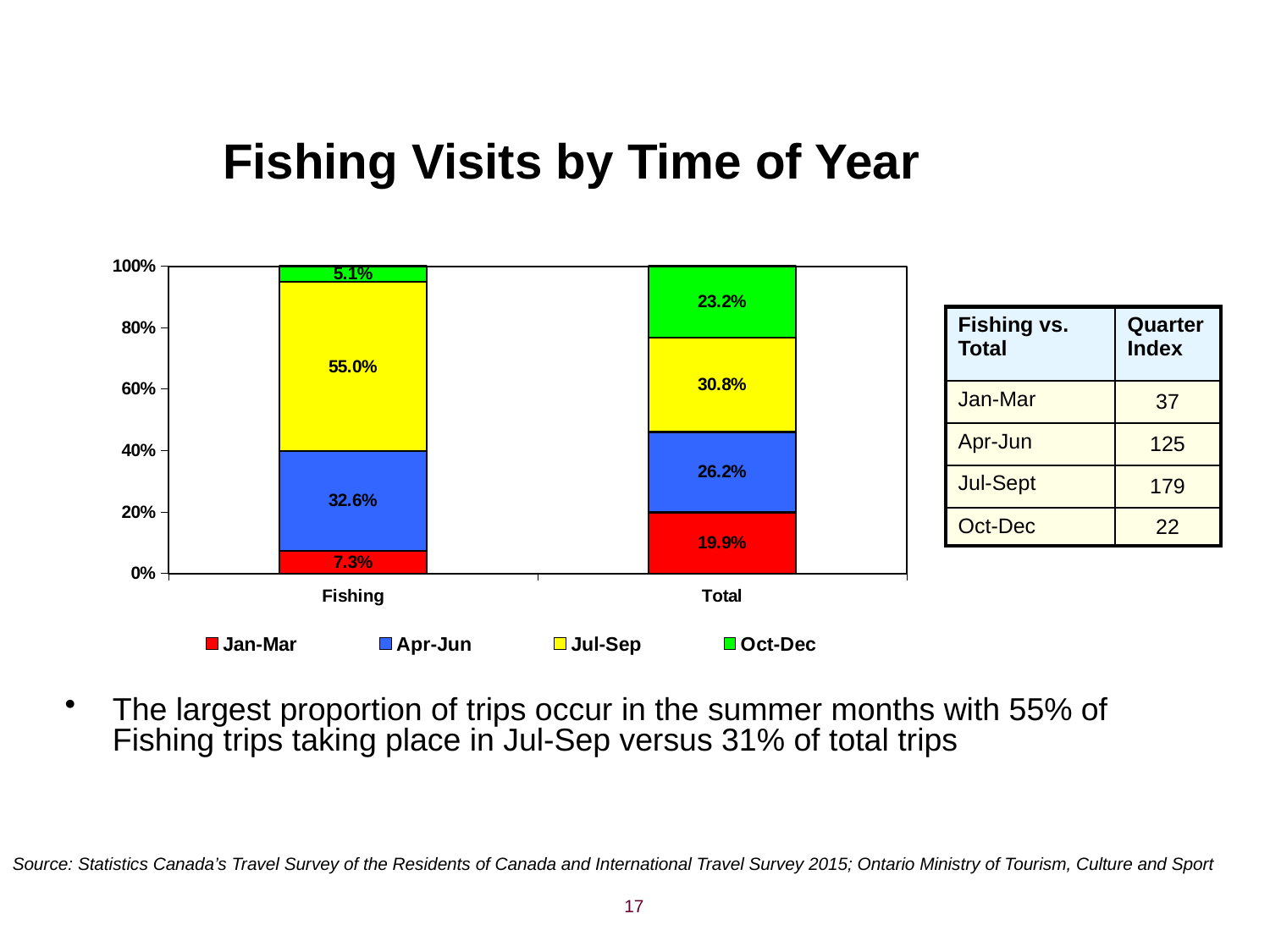
What is the Jul-Sep value for Fishing? 55.0% How many categories are shown on the x axis? 2 Which is larger, the Oct-Dec value for Fishing or for Total? Total Which quarter has the smallest share of the Fishing bar? Oct-Dec What is the difference between the Jul-Sep values for Fishing and Total? 24.2% What kind of chart is shown? Stacked bar chart Which colour represents Apr-Jun in the legend? Blue Which quarter has the largest share of the Fishing bar? Jul-Sep What is the Jan-Mar value for Total? 19.9% What is the Apr-Jun value for Total? 26.2% How many series does the legend list? 4 What is the Oct-Dec value for Fishing? 5.1%